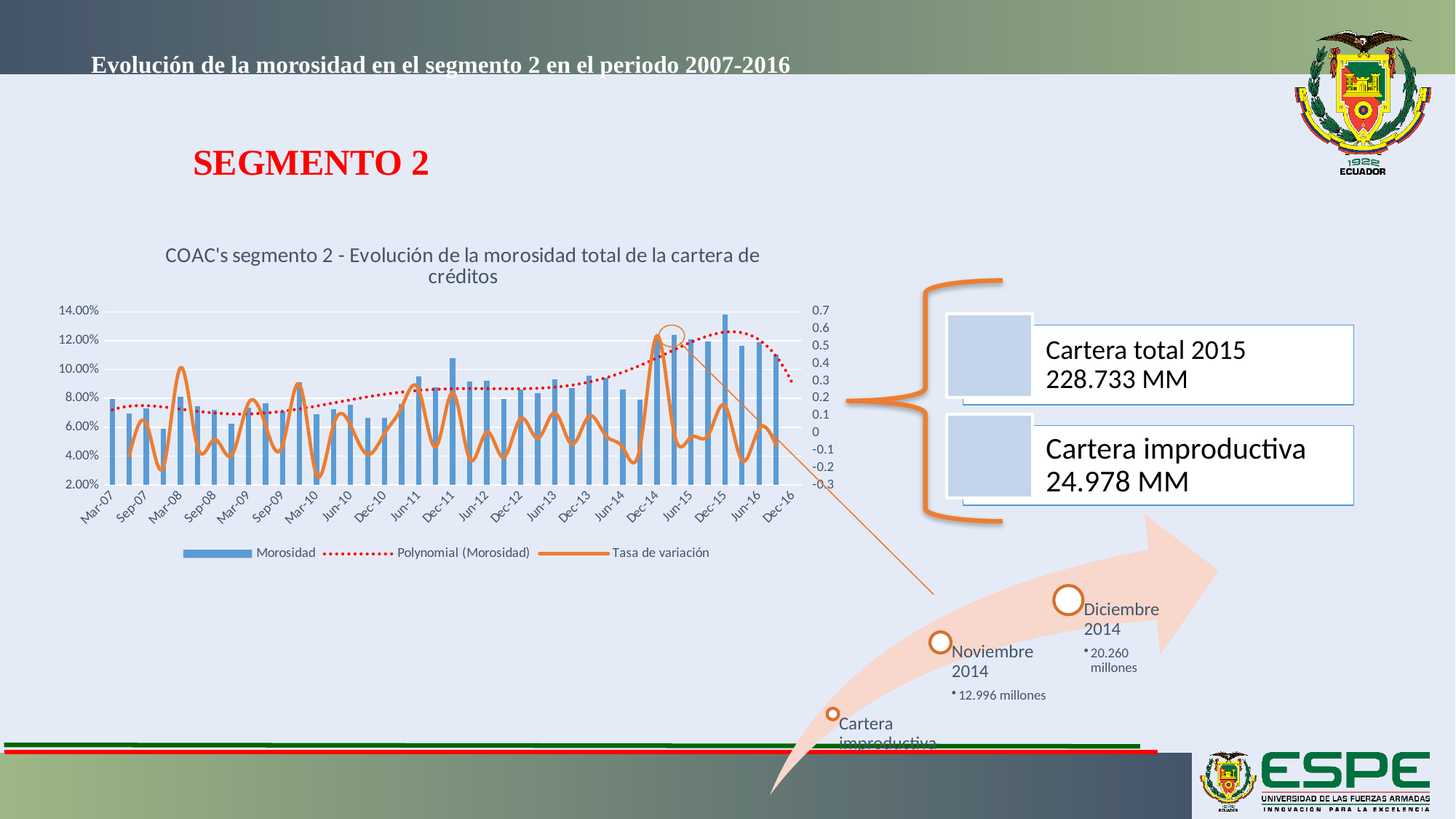
Is the Morosidad value for Dec-11 greater or less than 10.00%? greater What kind of chart is used to show the Morosidad series in the chart 'COAC's segmento 2 - Evolución de la morosidad total de la cartera de créditos'? bar chart At which x-axis label does the Morosidad bar reach its highest value? Dec-15 What is the title of the chart on the slide? COAC's segmento 2 - Evolución de la morosidad total de la cartera de créditos Which has the larger Morosidad value, Dec-15 or Mar-07? Dec-15 Which series are listed in the chart's legend? Morosidad, Polynomial (Morosidad), Tasa de variación Is the Morosidad value for Dec-15 greater or less than 12.00%? greater How many series does the legend of the chart list? 3 Is the Morosidad value for Mar-10 greater or less than 8.00%? less Which has the larger Morosidad value, Dec-11 or Dec-10? Dec-11 Does the dotted Polynomial (Morosidad) trend line generally rise or fall from Mar-07 to Dec-15? rise